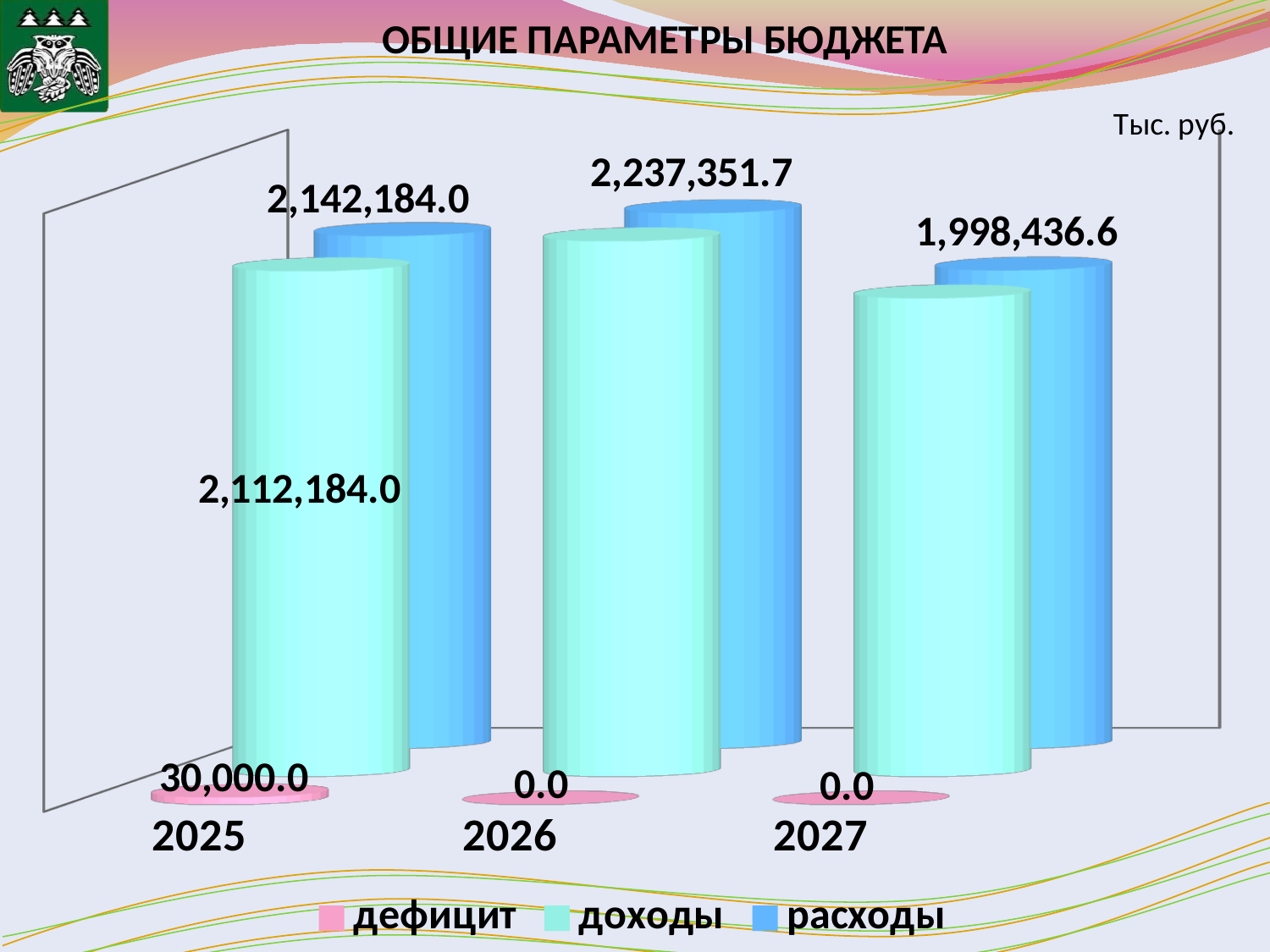
What is the value of расходы for 2027? 1,998,436.6 How many series does the legend list? 3 What is the value of дефицит for 2025? 30,000.0 What is the value of дефицит for 2027? 0.0 What is the difference between расходы and доходы in 2025? 30,000.0 What is the title of the chart? ОБЩИЕ ПАРАМЕТРЫ БЮДЖЕТА What is the difference between расходы in 2026 and расходы in 2027? 238,915.1 In which year is расходы highest? 2026 What is the value of расходы for 2025? 2,142,184.0 What is the value of расходы for 2026? 2,237,351.7 In which year is расходы lowest? 2027 What is the value of доходы for 2025? 2,112,184.0